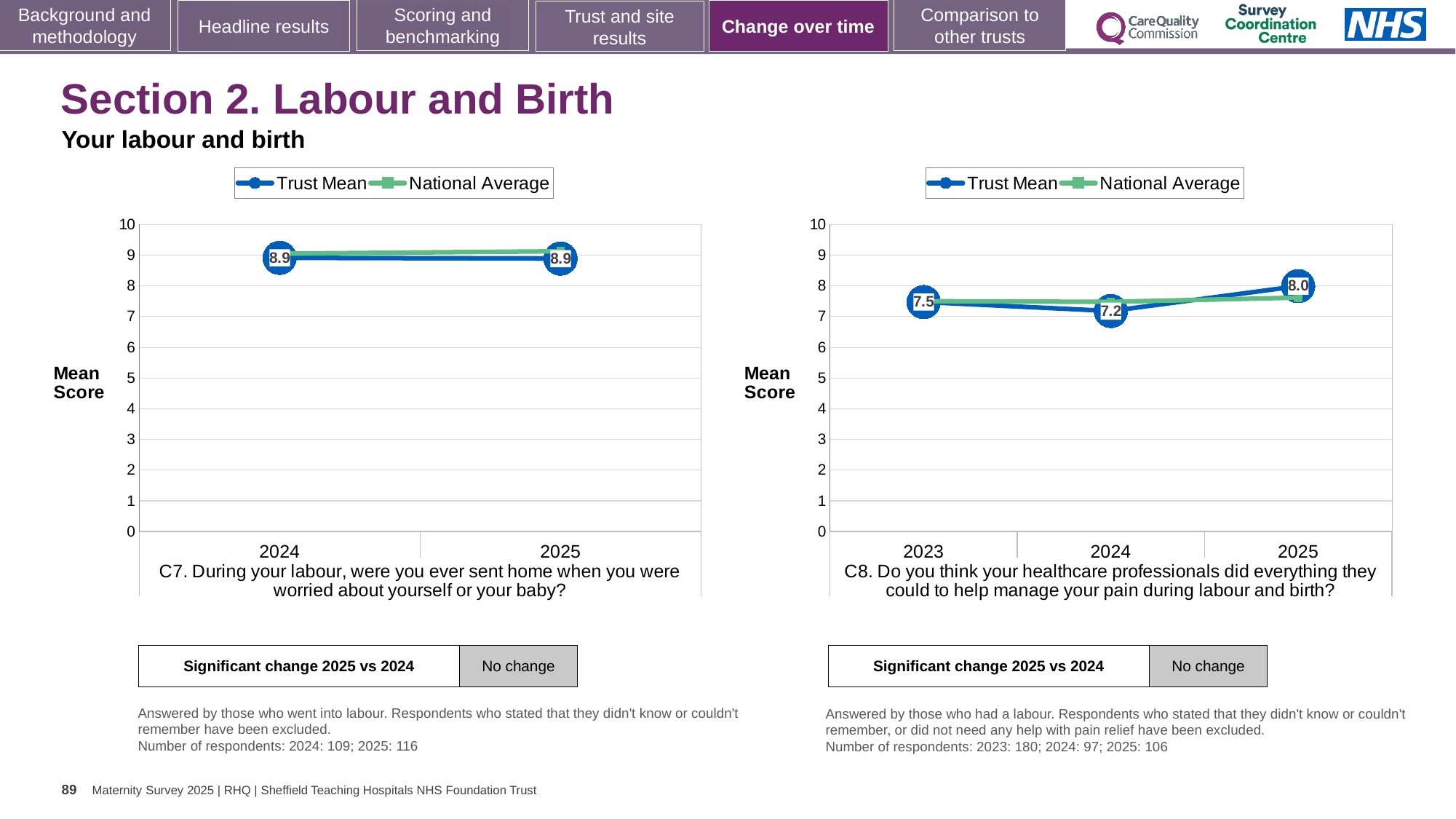
How many series does the legend of the C7 chart (left) list? 2 On the C8 chart (right), what is the difference between the Trust Mean for 2025 and the Trust Mean for 2024? 0.8 On the C8 chart (right), what is the Trust Mean for 2023? 7.5 On the C7 chart (left), what is the Trust Mean for 2024? 8.9 On the C8 chart (right), is the Trust Mean for 2023 greater or less than 7? greater On the C8 chart (right), which year has the highest Trust Mean? 2025 How many years are shown on the x axis of the C8 chart (right)? 3 On the C8 chart (right), what is the Trust Mean for 2025? 8.0 What kind of chart is the C7 chart (left)? Line chart On the C7 chart (left), what is the Trust Mean for 2025? 8.9 On the C8 chart (right), which year has the lowest Trust Mean? 2024 On the C8 chart (right), what is the Trust Mean for 2024? 7.2